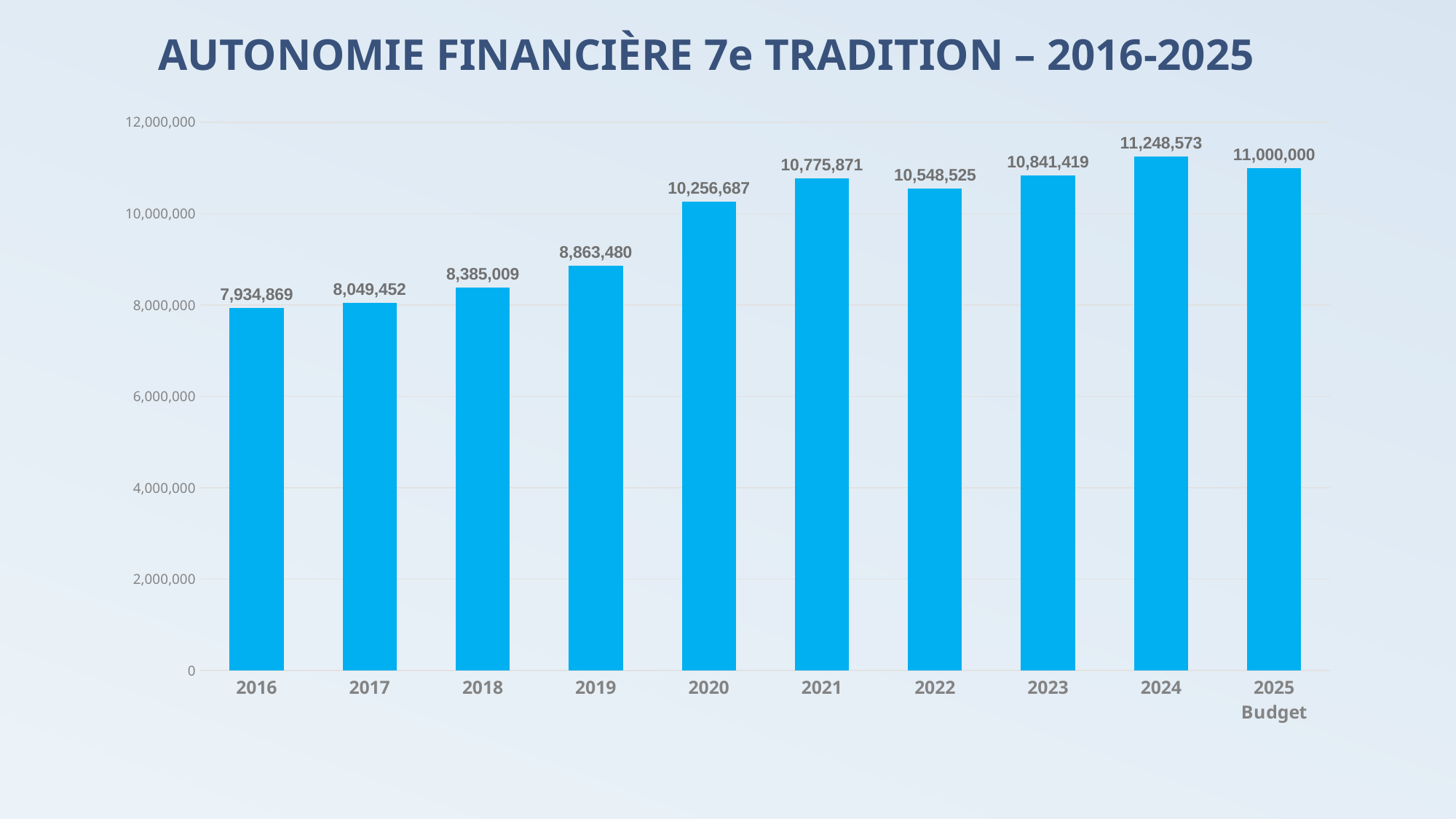
What is the value shown for 2025 Budget? 11,000,000 What is the value for 2020? 10,256,687 Which is larger, the value for 2021 or the value for 2022? 2021 What kind of chart is shown on the slide? bar chart What is the title of the chart? AUTONOMIE FINANCIÈRE 7e TRADITION – 2016-2025 Which year has the lowest value? 2016 What is the value for 2016? 7,934,869 Is the value for 2019 greater or less than 10,000,000? less What is the difference between the values for 2024 and 2016? 3,313,704 How many bars are shown in the chart? 10 Which year has the highest value? 2024 What is the difference between the values for 2021 and 2020? 519,184